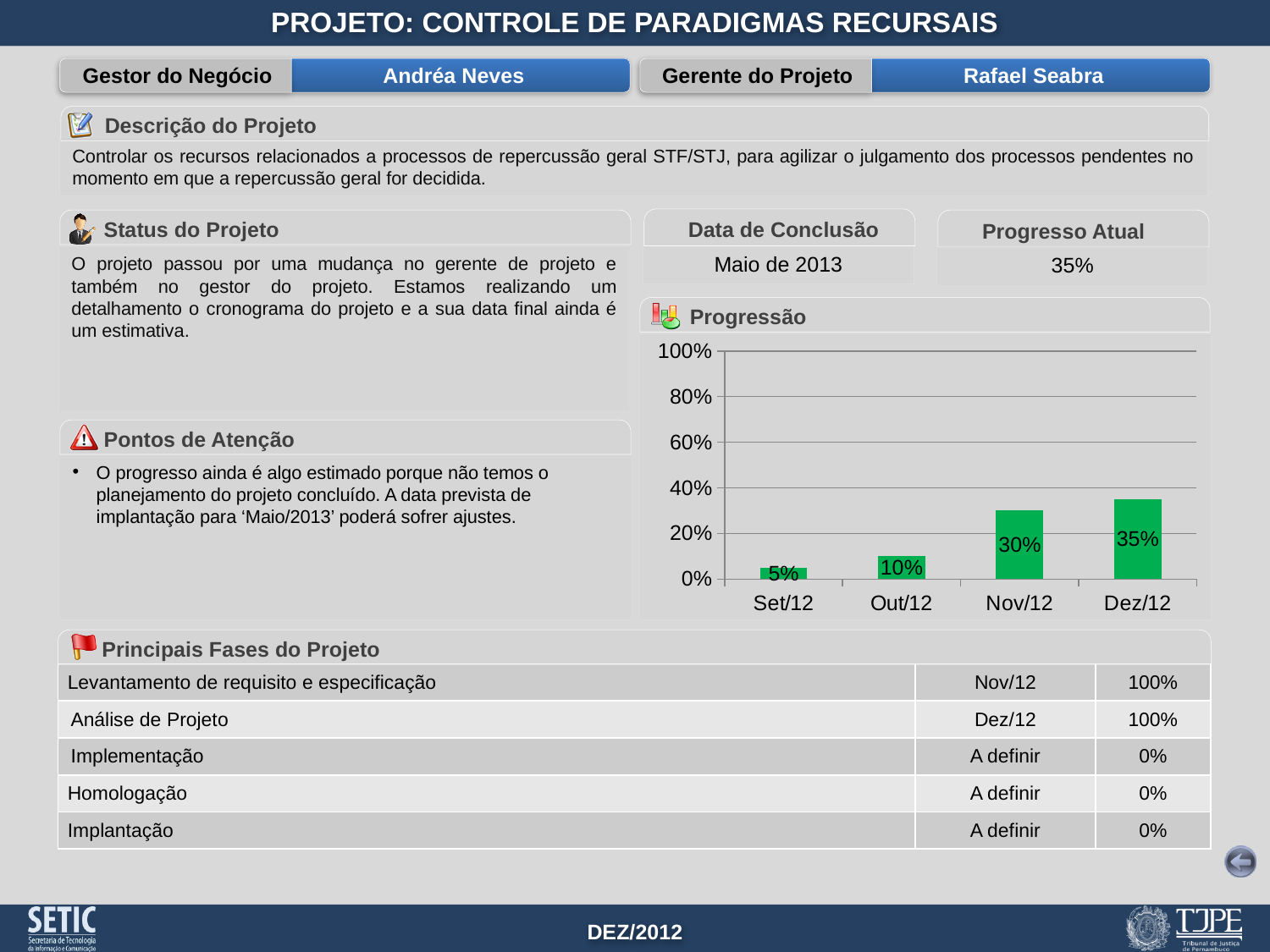
In the Progressão chart, which month has the lowest value? Set/12 In the Progressão chart, which is larger, the value for Nov/12 or the value for Dez/12? Dez/12 In the Progressão chart, what is the value for Dez/12? 35% In the Progressão chart, what is the value for Nov/12? 30% In the Progressão chart, do the values rise or fall from Set/12 to Dez/12? rise In the Progressão chart, which month has the highest value? Dez/12 What kind of chart is the Progressão chart? bar chart In the Progressão chart, what is the value for Set/12? 5% How many months are shown on the x axis of the Progressão chart? 4 In the Progressão chart, what is the value for Out/12? 10% In the Progressão chart, what is the difference between the values for Nov/12 and Out/12? 20% In the Progressão chart, is the value for Nov/12 greater or less than 20%? greater